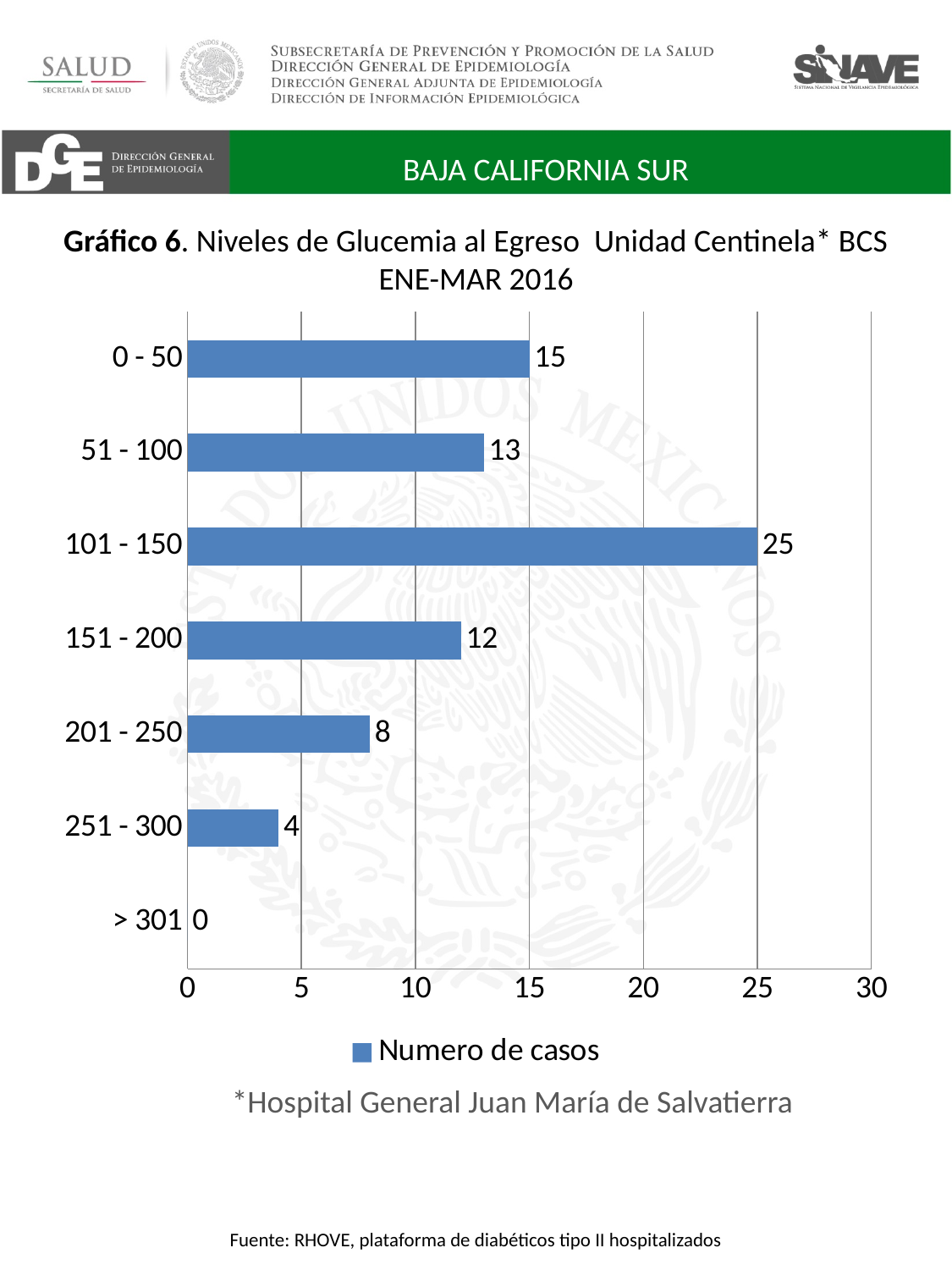
How many series does the legend list? 1 What is the maximum value shown on the horizontal axis? 30 What is the difference in number of cases between the 101 - 150 and 151 - 200 categories? 13 What kind of chart is shown on the slide? Bar chart Which glucose level category has the highest number of cases? 101 - 150 What is the number of cases for the 101 - 150 glucose level category? 25 What is the name of the series shown in the legend? Numero de casos Which category has more cases, 51 - 100 or 201 - 250? 51 - 100 What is the number of cases for the 251 - 300 category? 4 Which glucose level category has the lowest number of cases? > 301 How many glucose level categories are shown on the chart? 7 What is the number of cases for the 0 - 50 category? 15